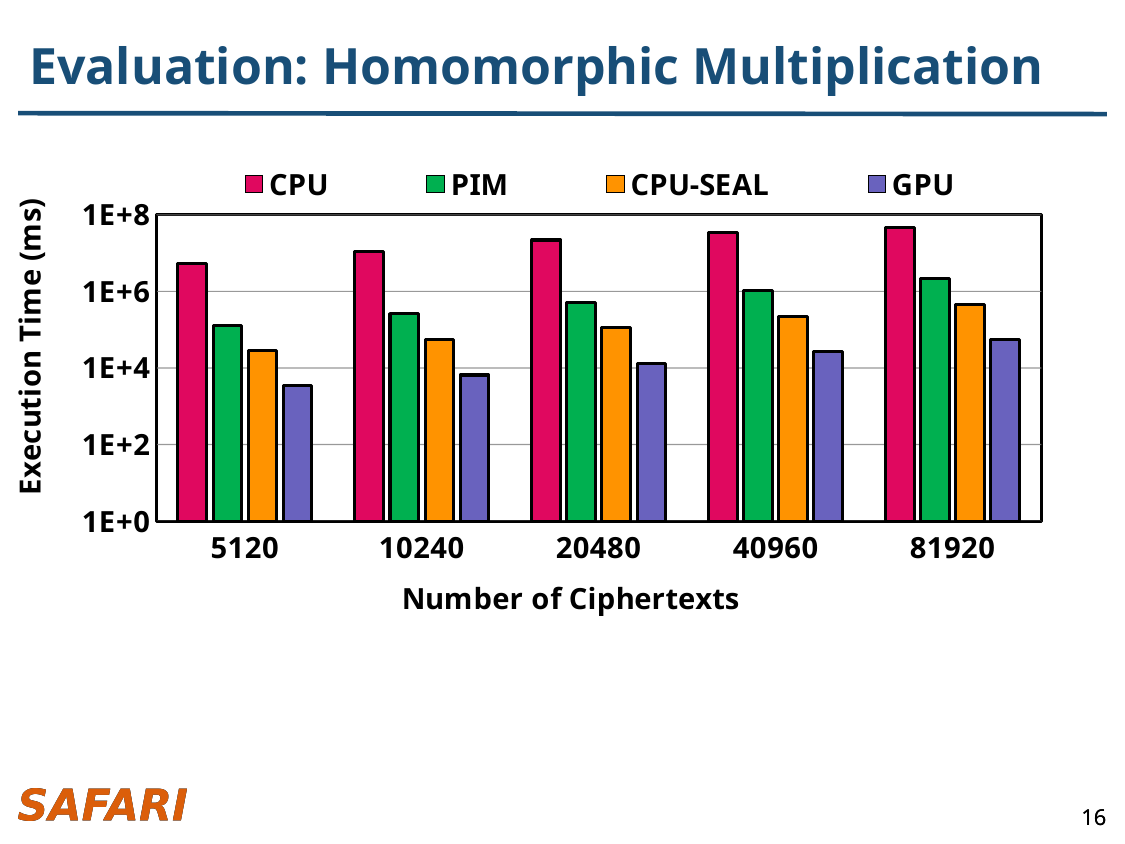
Is the execution time for CPU at 5120 ciphertexts greater or less than 1E+6? greater Is the execution time for GPU at 81920 ciphertexts greater or less than 1E+4? greater Which is larger at 20480 ciphertexts, the execution time for PIM or for CPU-SEAL? PIM Which series has the highest execution time for 81920 ciphertexts? CPU Is the execution time for GPU at 5120 ciphertexts greater or less than 1E+4? less What kind of chart is shown on the slide? bar chart How many categories are shown on the x axis (Number of Ciphertexts)? 5 How many series does the legend list? 4 What is the label of the y axis? Execution Time (ms) Does the execution time for CPU rise or fall as the number of ciphertexts increases? rise Which series has the lowest execution time for 5120 ciphertexts? GPU